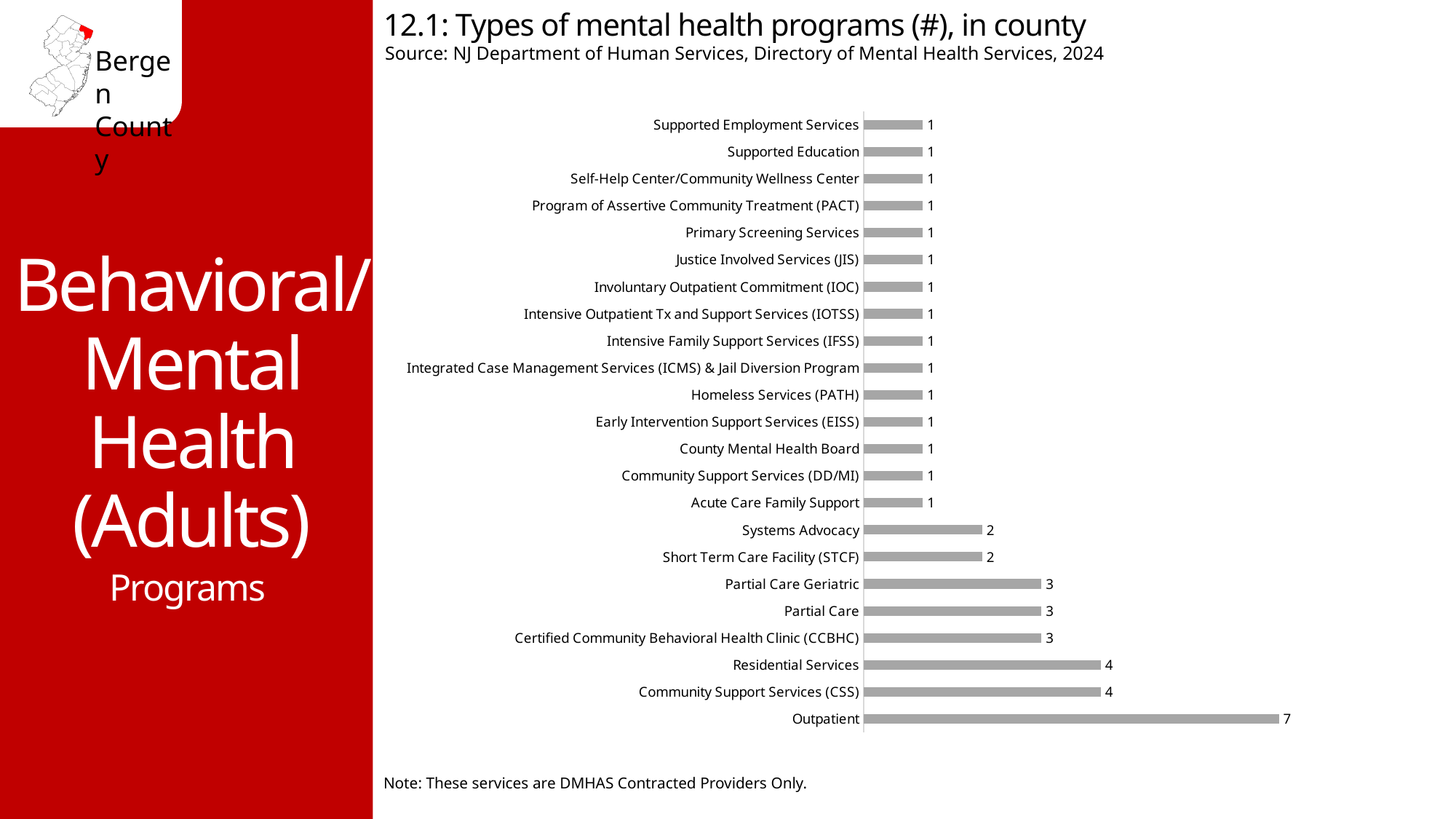
What is the difference between the values for Residential Services and Partial Care Geriatric? 1 Which category has the highest number of programs? Outpatient How many categories have a value of 1? 15 What type of chart is shown on the slide? Bar chart What is the value for Certified Community Behavioral Health Clinic (CCBHC)? 3 What is the value for Residential Services? 4 What is the value for Short Term Care Facility (STCF)? 2 How many programs does the Outpatient category have? 7 What is the difference between the values for Outpatient and Community Support Services (CSS)? 3 What is the title of the chart? 12.1: Types of mental health programs (#), in county How many categories are shown in the chart? 23 Which is larger, the value for Partial Care or the value for Systems Advocacy? Partial Care